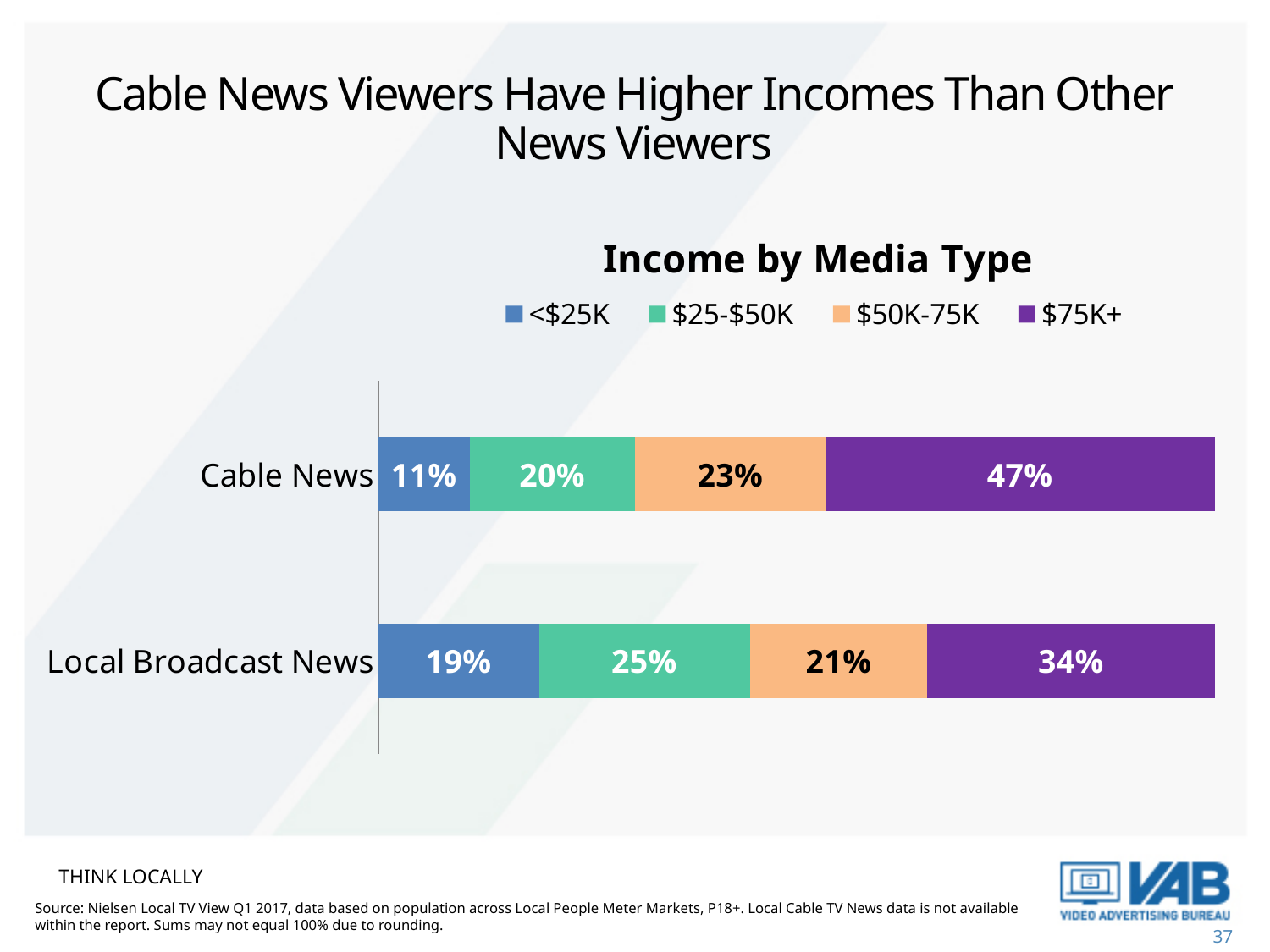
How many media types are shown on the chart? 2 What type of chart is shown on the slide? Stacked bar chart Which media type has the lower share of viewers with incomes under $25K? Cable News What is the difference between the <$25K shares for Local Broadcast News and Cable News? 8 percentage points What percentage of Local Broadcast News viewers have incomes under $25K? 19% Which income segment is the largest for Local Broadcast News? $75K+ What is the difference between the $75K+ shares for Cable News and Local Broadcast News? 13 percentage points What percentage of Cable News viewers have incomes of $75K+? 47% What is the $25-$50K value for Cable News? 20% What is the $50K-75K value for Local Broadcast News? 21% How many income segments does the legend list? 4 Which media type has the higher share of viewers with incomes of $75K+? Cable News